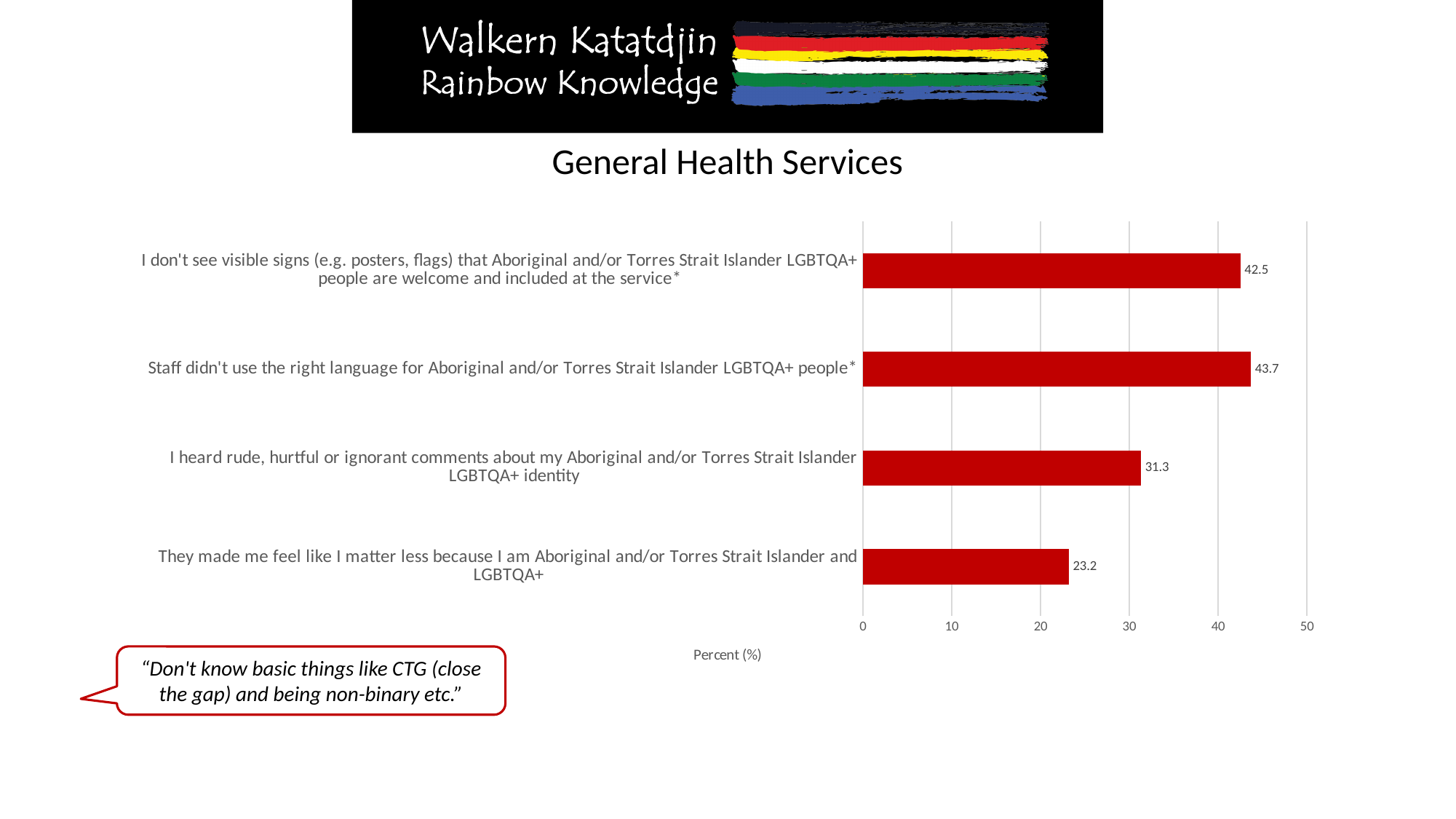
What is the label of the horizontal axis? Percent (%) How many categories are shown in the chart? 4 What is the value for "I heard rude, hurtful or ignorant comments about my Aboriginal and/or Torres Strait Islander LGBTQA+ identity"? 31.3 What is the difference between the values for "I heard rude, hurtful or ignorant comments" and "They made me feel like I matter less"? 8.1 Which category has the highest value? Staff didn't use the right language for Aboriginal and/or Torres Strait Islander LGBTQA+ people Which category has the lowest value? They made me feel like I matter less because I am Aboriginal and/or Torres Strait Islander and LGBTQA+ What is the value for "Staff didn't use the right language for Aboriginal and/or Torres Strait Islander LGBTQA+ people"? 43.7 What is the value for "I don't see visible signs (e.g. posters, flags) that Aboriginal and/or Torres Strait Islander LGBTQA+ people are welcome and included at the service"? 42.5 Which is larger: the value for "I heard rude, hurtful or ignorant comments" or the value for "I don't see visible signs"? I don't see visible signs What is the value for "They made me feel like I matter less because I am Aboriginal and/or Torres Strait Islander and LGBTQA+"? 23.2 What is the difference between the values for "Staff didn't use the right language" and "They made me feel like I matter less"? 20.5 What kind of chart is shown on the slide? Bar chart